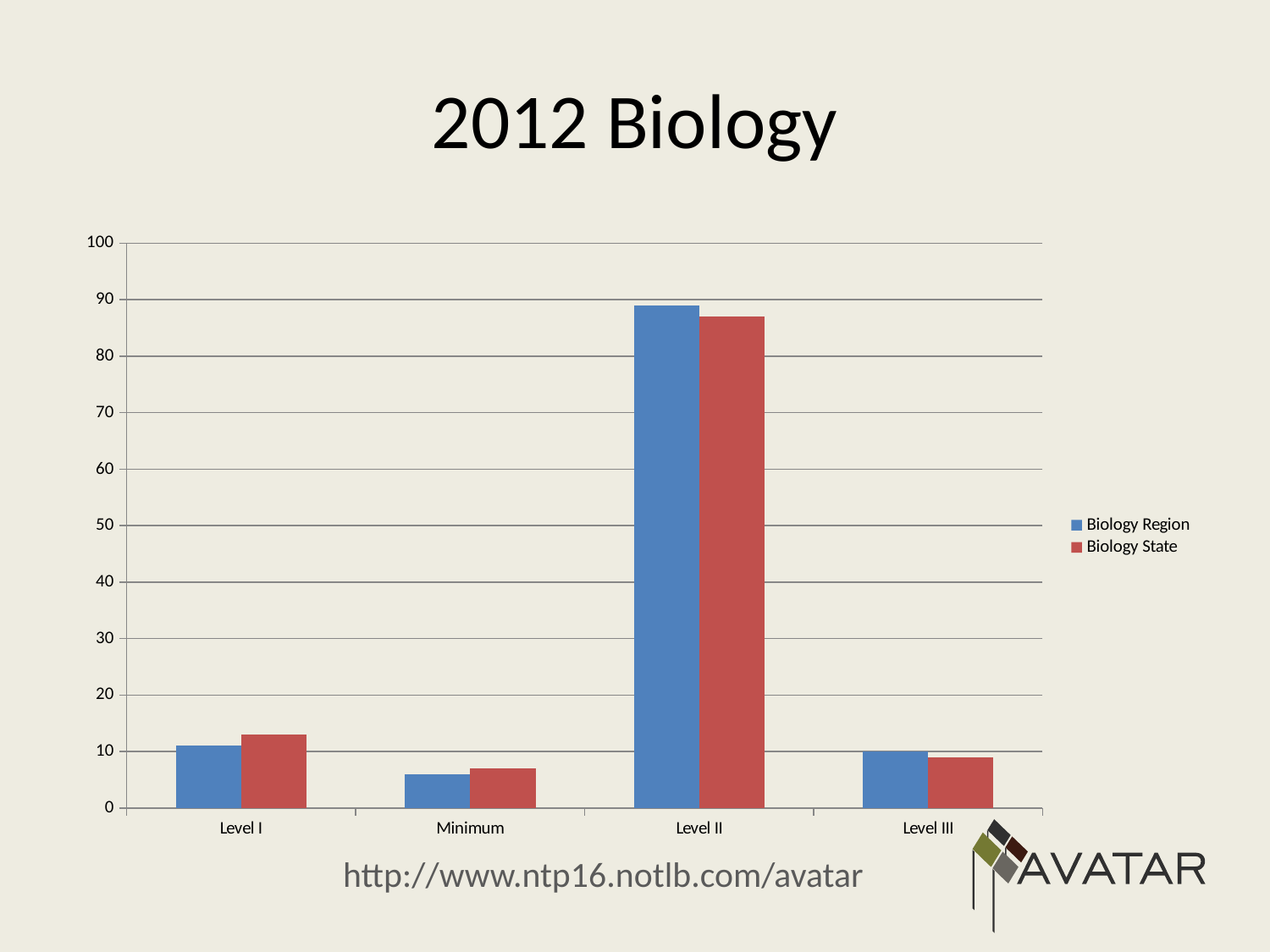
How many categories are shown on the x axis? 4 Is the Biology Region value for Level II greater or less than 80? greater What is the title of the chart? 2012 Biology For Level I, which is larger: Biology Region or Biology State? Biology State How many series does the legend list? 2 For Level II, which is larger: Biology Region or Biology State? Biology Region Is the Biology State value for Level I greater or less than 20? less Is the Biology State value for Level II greater or less than 90? less Which category has the lowest Biology State value? Minimum What kind of chart is shown on the slide? bar chart Which category has the highest Biology Region value? Level II